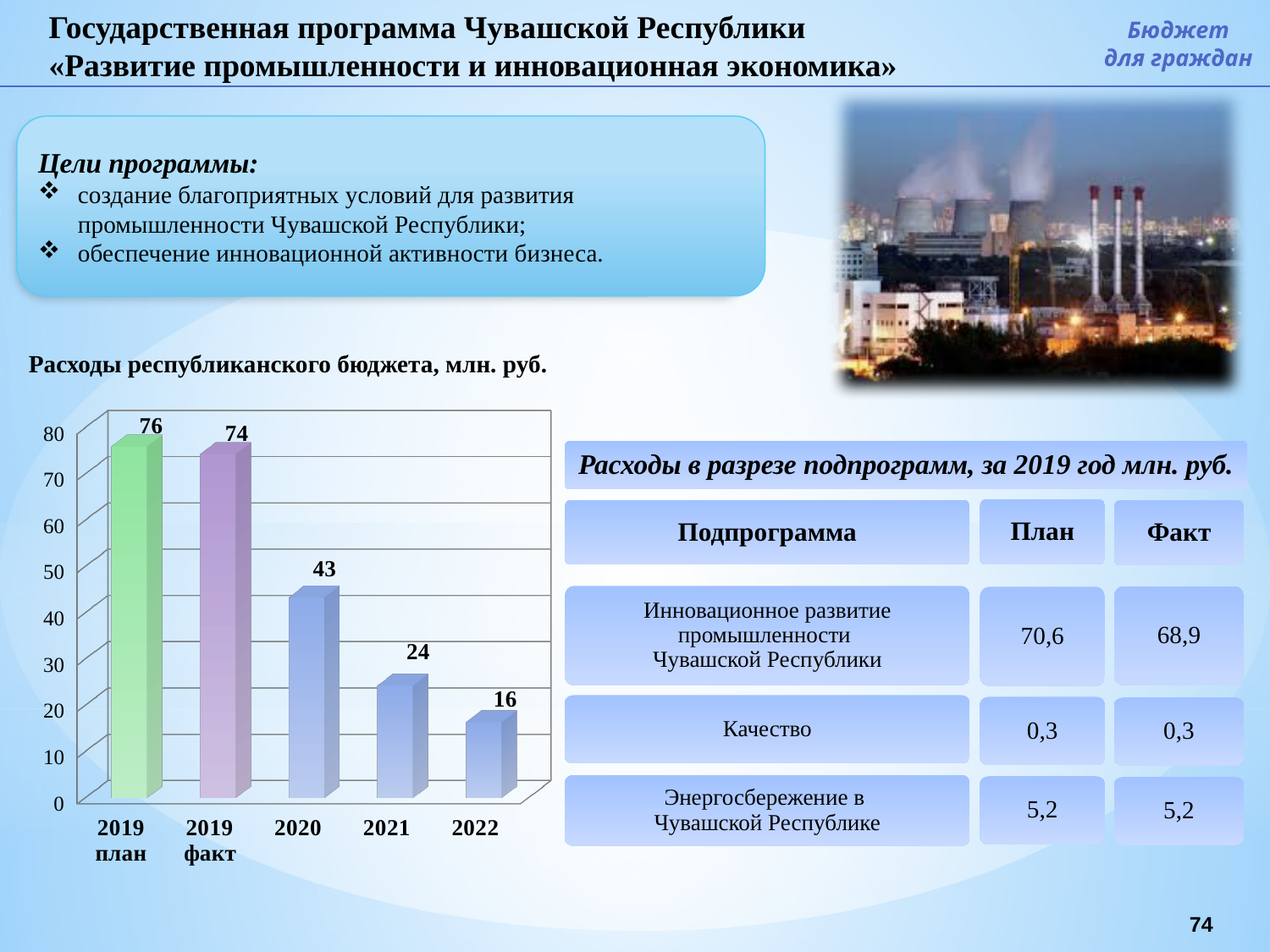
What is the value for 2019 план in the chart 'Расходы республиканского бюджета, млн. руб.'? 76 Do the values rise or fall from 2020 to 2022 in the chart? fall What is the value for 2019 факт in the chart? 74 Which is larger, the value for 2021 or the value for 2022? 2021 What is the difference between the values for 2020 and 2021? 19 How many bars are shown in the chart? 5 Which category has the lowest value in the chart? 2022 What is the value for 2022 in the chart? 16 What is the difference between the values for 2019 план and 2019 факт? 2 What kind of chart is shown on the slide? bar chart Which category has the highest value in the chart? 2019 план What is the value for 2020 in the chart? 43